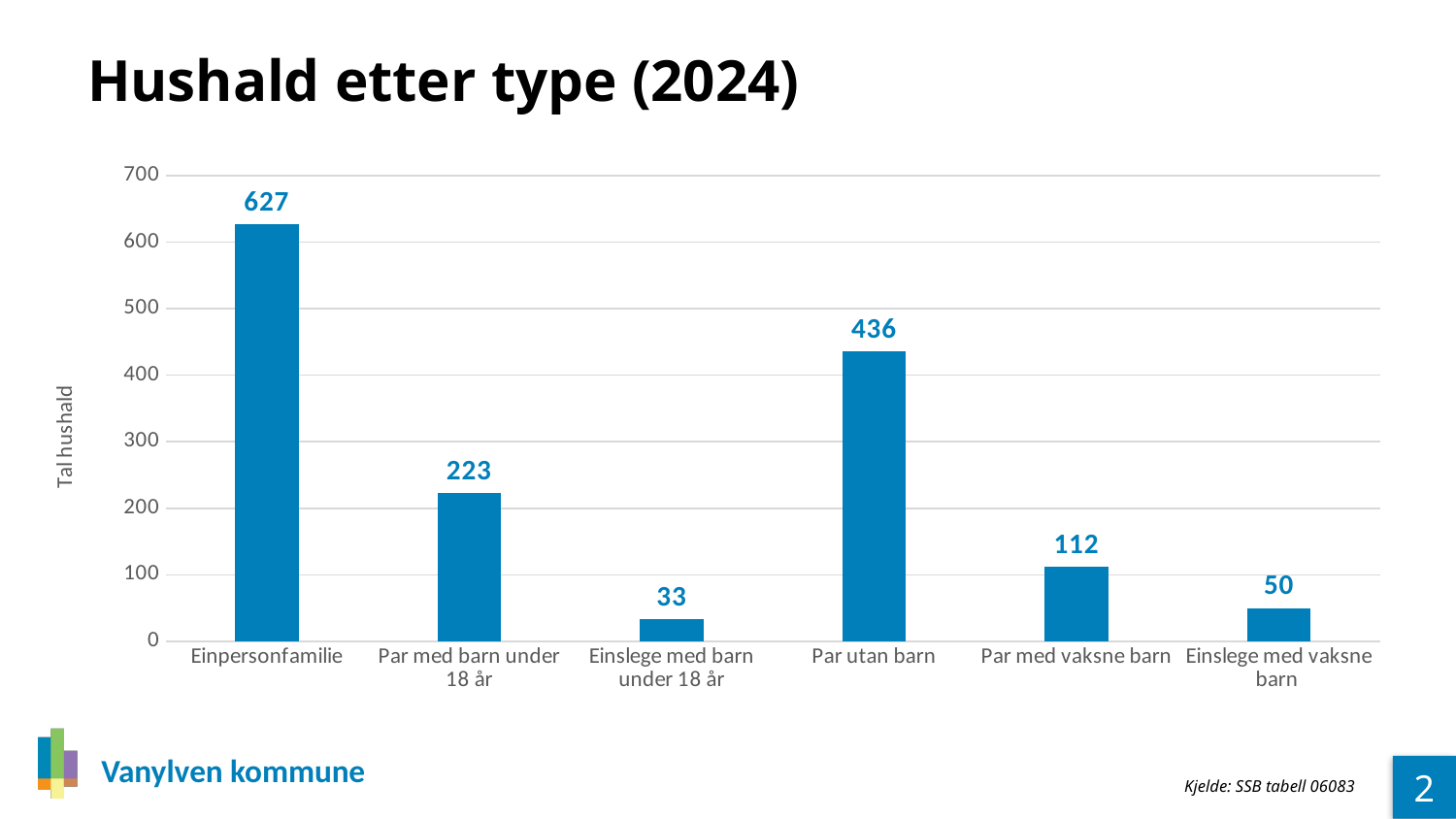
What is the difference between Einpersonfamilie and Par utan barn? 191 Which category has the highest value? Einpersonfamilie What is the value for Par utan barn? 436 Which is larger, Par med barn under 18 år or Par med vaksne barn? Par med barn under 18 år Which category has the lowest value? Einslege med barn under 18 år Is the value for Einslege med vaksne barn greater or less than 100? less What is the value for Par med vaksne barn? 112 How many categories are shown on the x axis? 6 What is the value for Einpersonfamilie? 627 What is the value for Einslege med barn under 18 år? 33 What is the title of the chart? Hushald etter type (2024) What kind of chart is shown on the slide? bar chart